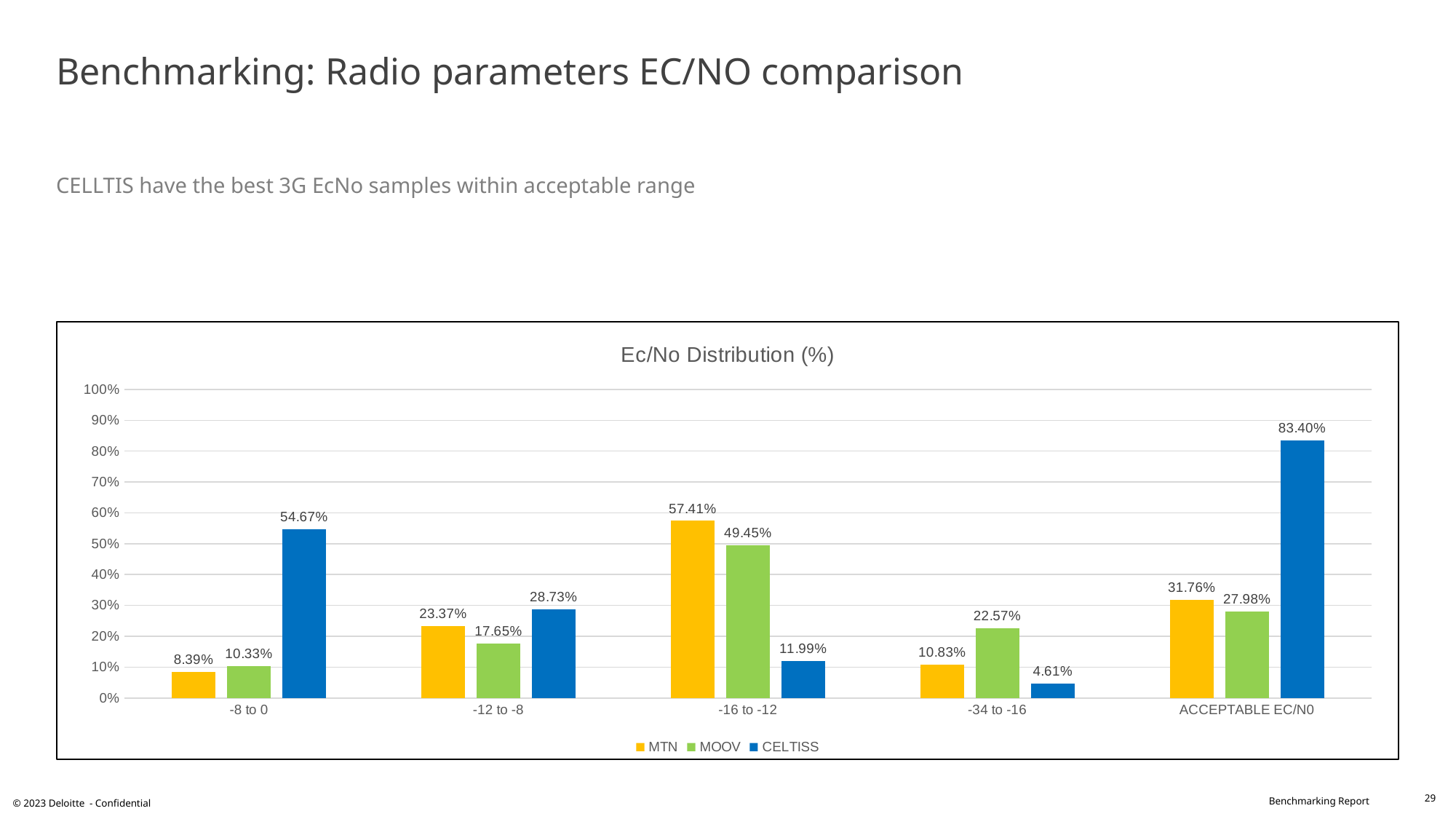
What is the CELTISS value for ACCEPTABLE EC/N0? 83.40% How many categories are shown on the x axis? 5 Which operator has the highest value in the -8 to 0 category? CELTISS In the -12 to -8 category, which is larger: the MTN value or the MOOV value? MTN Which operator has the lowest value in the -34 to -16 category? CELTISS What kind of chart is shown? bar chart How many series does the legend list? 3 What is the MTN value for the -16 to -12 category? 57.41% What is the difference between the CELTISS and MTN values for ACCEPTABLE EC/N0? 51.64% Is the CELTISS value for -16 to -12 greater or less than 20%? less What is the title of the chart? Ec/No Distribution (%) What is the MOOV value for the -34 to -16 category? 22.57%